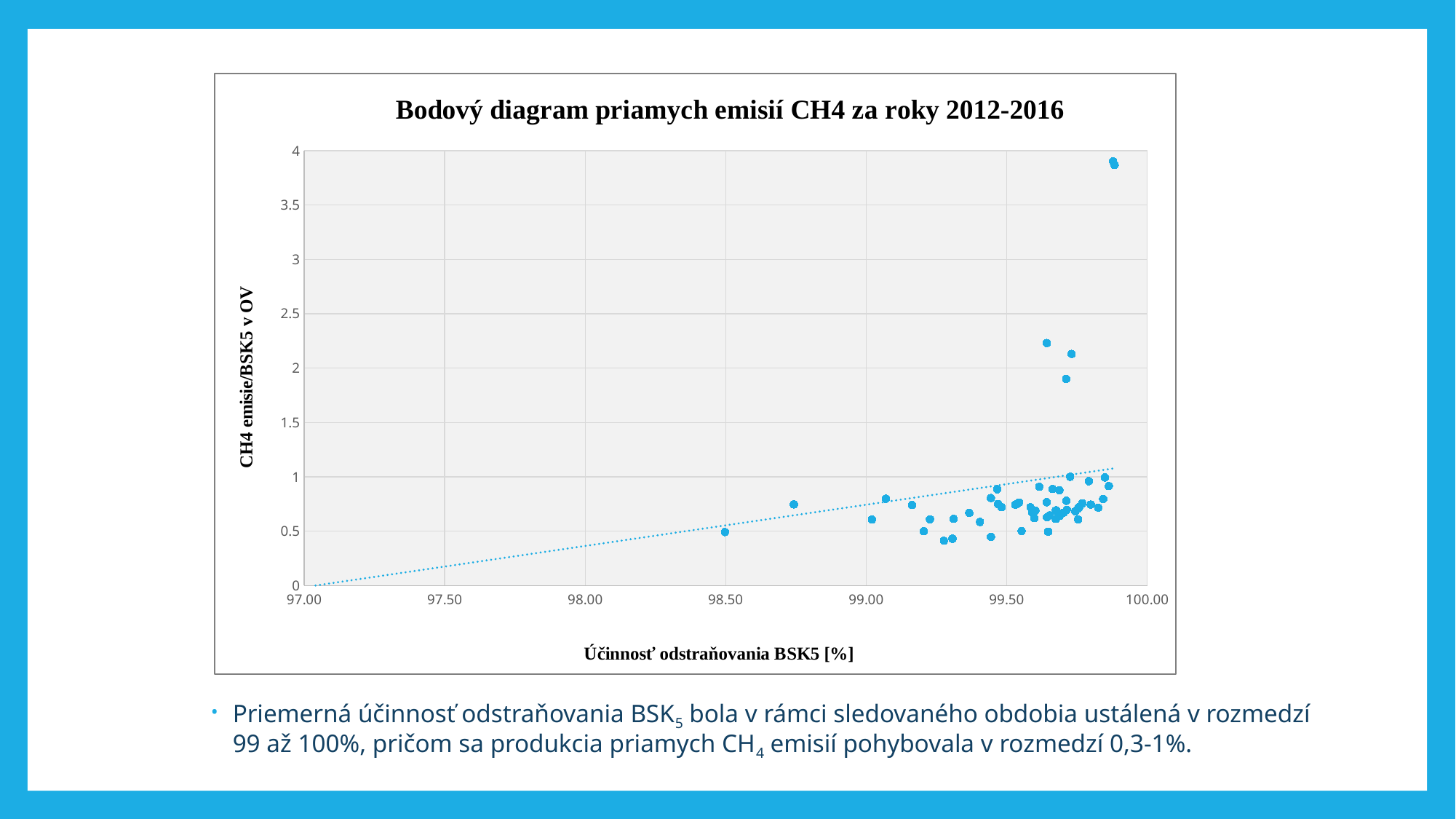
Are the three points plotted between y = 1.5 and y = 2.5 located at x values greater or less than 99.00? greater What is the label of the x axis? Účinnosť odstraňovania BSK5 [%] Is the y value of the leftmost point (near x = 98.50) greater or less than 1? less Does the dotted trend line rise or fall as the x axis value increases? rises Is the x value of the highest point greater or less than 99.50? greater What kind of chart is shown on the slide? scatter plot What is the title of the chart? Bodový diagram priamych emisií CH4 za roky 2012-2016 What is the maximum value shown on the y axis? 4 Which is larger: the y value of the highest point (near x = 99.87) or the y value of the point near x = 98.50? the point near x = 99.87